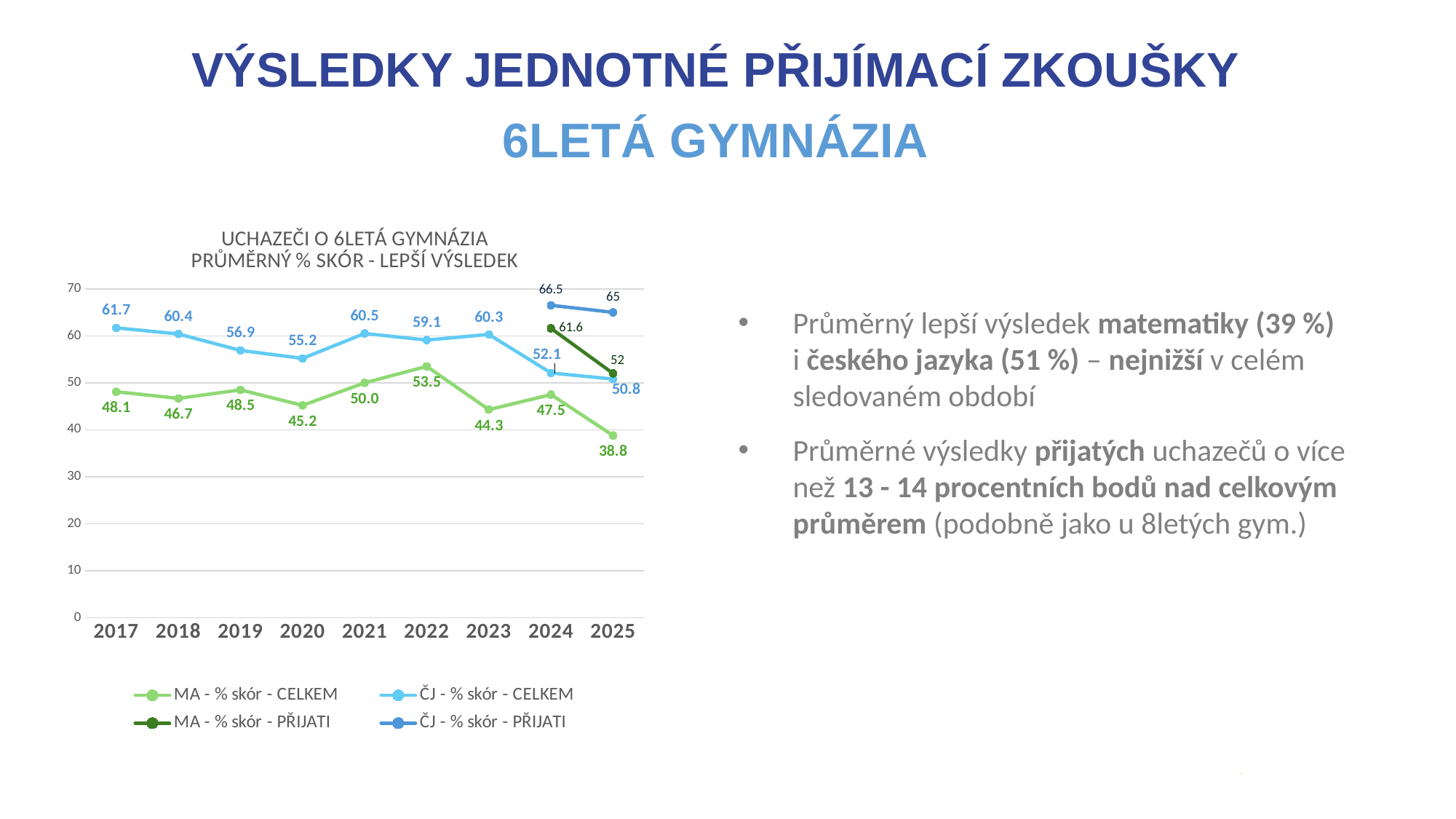
What is the value of MA - % skór - CELKEM in 2025? 38.8 Does ČJ - % skór - CELKEM rise or fall from 2023 to 2025? Fall What is the value of MA - % skór - PŘIJATI in 2025? 52 What kind of chart is shown on the slide? Line chart In which year is MA - % skór - CELKEM highest? 2022 What is the difference between ČJ - % skór - CELKEM and MA - % skór - CELKEM in 2025? 12.0 How many years are shown on the x axis? 9 In which year is ČJ - % skór - CELKEM lowest? 2025 Which is larger in 2024: MA - % skór - PŘIJATI or MA - % skór - CELKEM? MA - % skór - PŘIJATI What is the value of ČJ - % skór - PŘIJATI in 2024? 66.5 What is the value of ČJ - % skór - CELKEM in 2017? 61.7 How many series does the legend list? 4